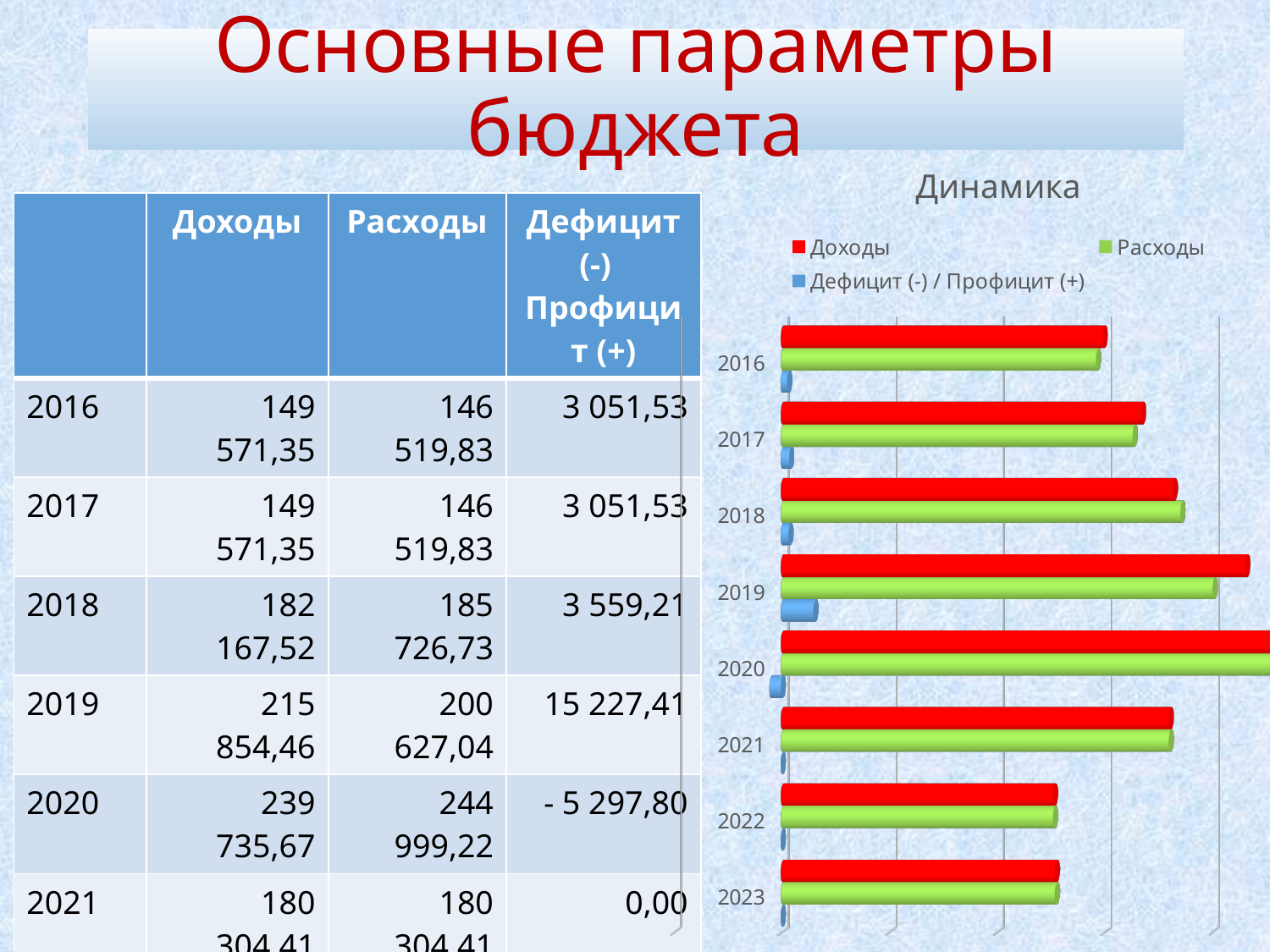
How many years are plotted on the "Динамика" chart? 8 In the "Динамика" chart, which year has the longest "Дефицит (-) / Профицит (+)" bar? 2019 What is the "Доходы" value for 2019 shown on the slide? 215 854,46 In the "Динамика" chart, is the "Доходы" bar for 2020 longer or shorter than the one for 2016? longer In the "Динамика" chart, which year is the only one whose "Дефицит (-) / Профицит (+)" bar extends to the left (negative)? 2020 Do the "Доходы" bars in the "Динамика" chart rise or fall from 2016 to 2020? rise What is the "Дефицит (-) / Профицит (+)" value for 2020 shown on the slide? - 5 297,80 In the "Динамика" chart for 2019, which is larger, "Доходы" or "Расходы"? Доходы How many series does the legend of the "Динамика" chart list? 3 What colour are the "Расходы" bars in the "Динамика" chart? green Which year has the longest "Доходы" bar in the "Динамика" chart? 2020 What kind of chart is shown under the title "Динамика"? bar chart